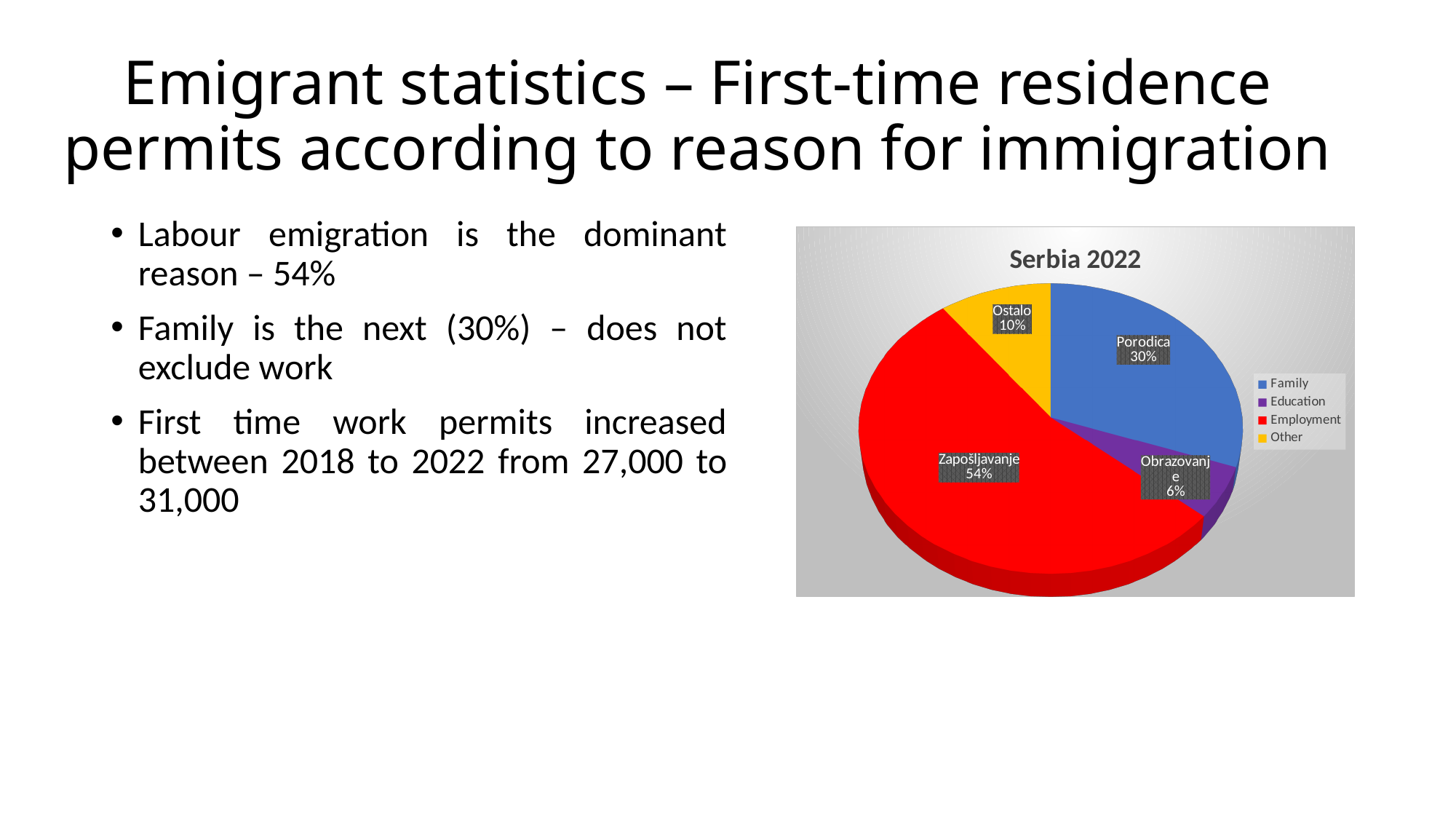
What type of chart is shown on the slide? pie chart Which category has the largest slice of the pie? Employment What colour is the Employment slice? red What share of the pie does Family (Porodica) hold? 30% Which slice is larger, Other or Education? Other Which category has the smallest slice of the pie? Education What is the title of the chart? Serbia 2022 What share of the pie does Employment (Zapošljavanje) hold? 54% What share of the pie does Education (Obrazovanje) hold? 6% How many categories does the legend list? 4 What is the difference in percentage points between the Employment and Family slices? 24